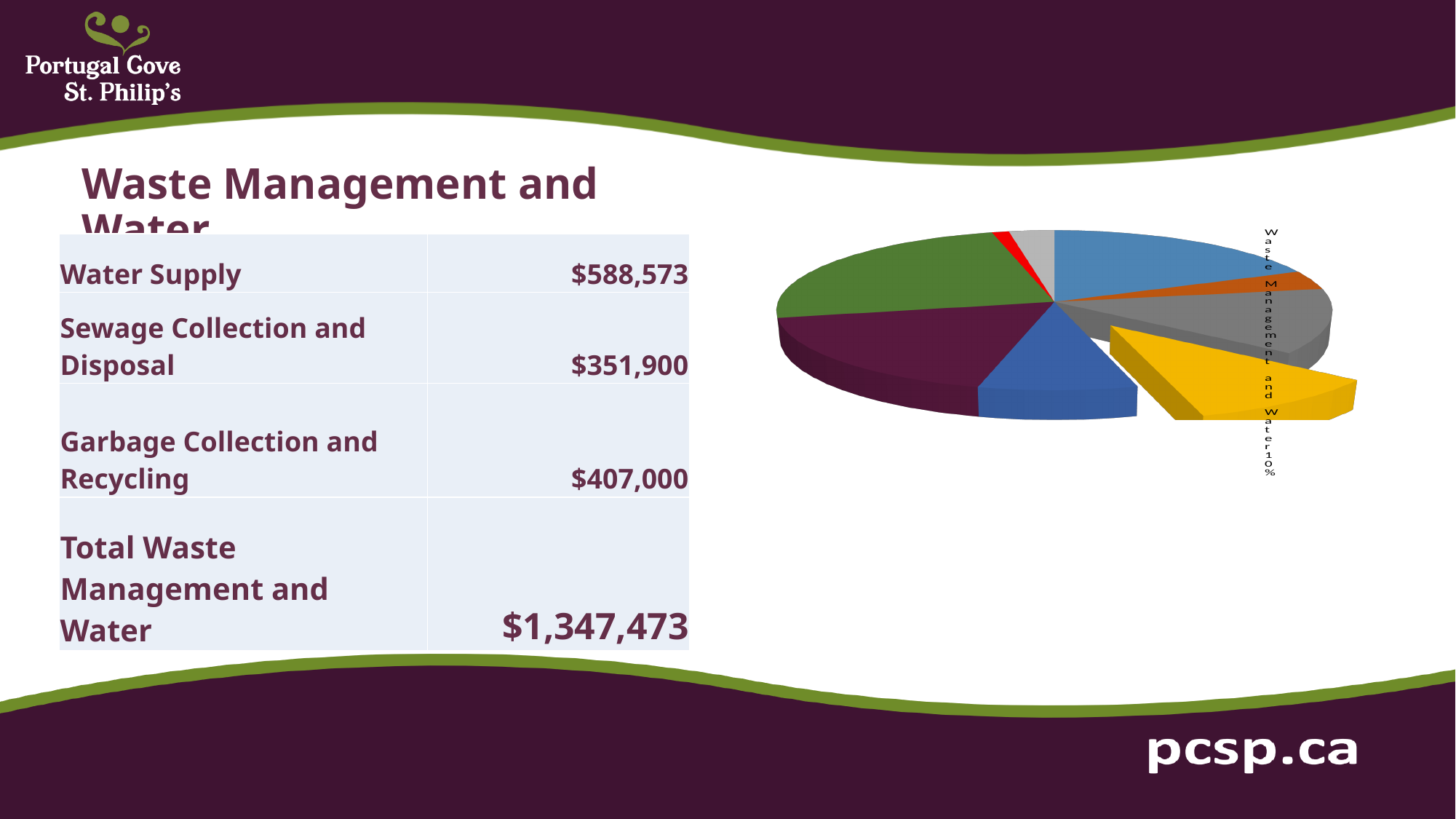
Which slice of the pie chart is labelled with a percentage? Waste Management and Water What kind of chart is shown on the slide? pie chart How many slices does the pie chart have? 9 What share of the pie chart does the Waste Management and Water slice represent? 10% What colour is the Waste Management and Water slice in the pie chart? yellow